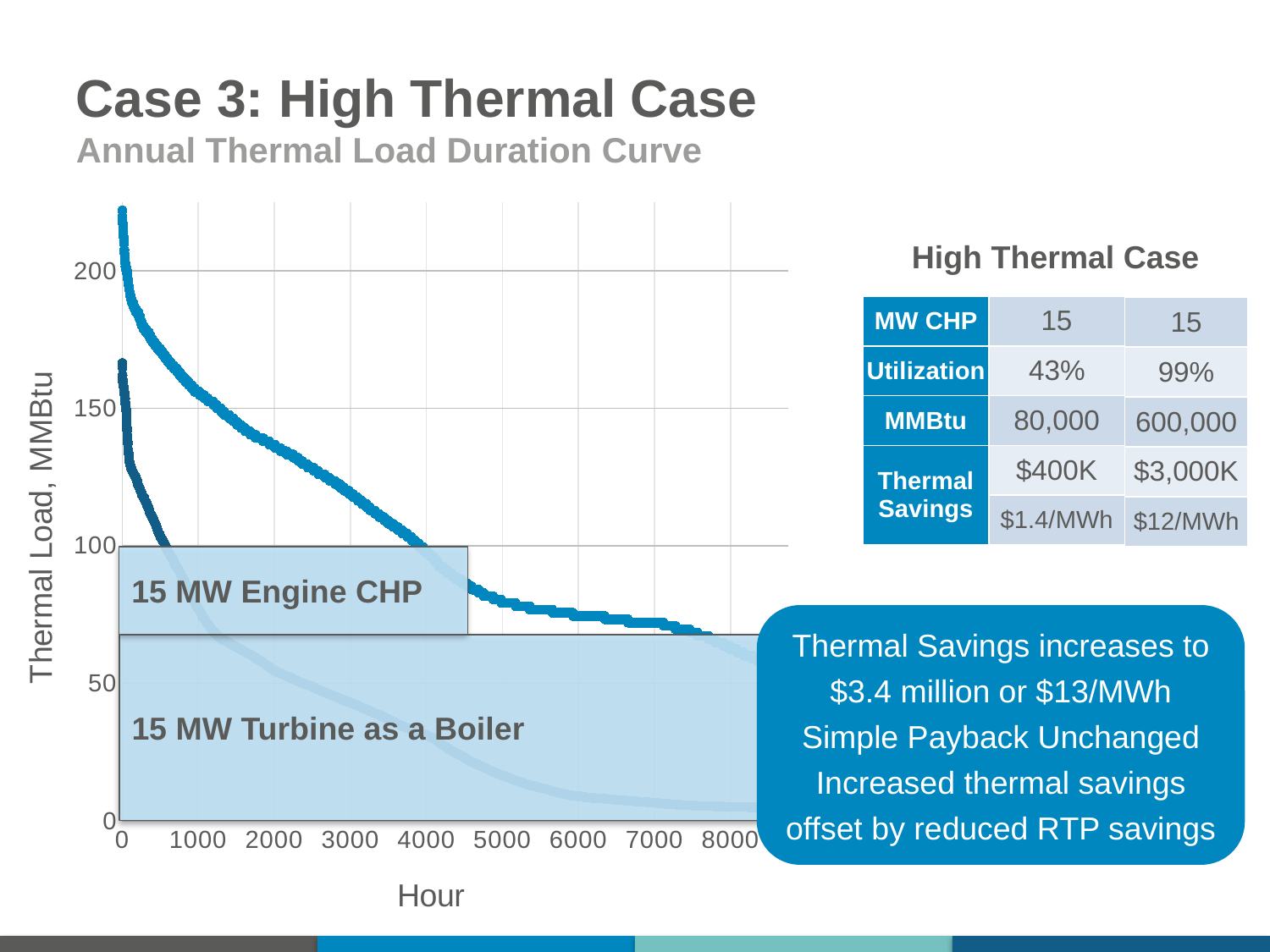
What label is shown in the lower shaded box on the chart? 15 MW Turbine as a Boiler What is the label of the y axis of the chart? Thermal Load, MMBtu Is the value of the light blue curve at hour 6000 greater or less than 100? less What kind of chart is shown on the slide? line chart Is the value of the light blue curve at hour 7000 greater or less than 100? less Is the value of the light blue curve at hour 2000 greater or less than 100? greater Do the plotted thermal load values rise or fall as the hour increases along the x axis? fall How many curves are plotted on the chart? 2